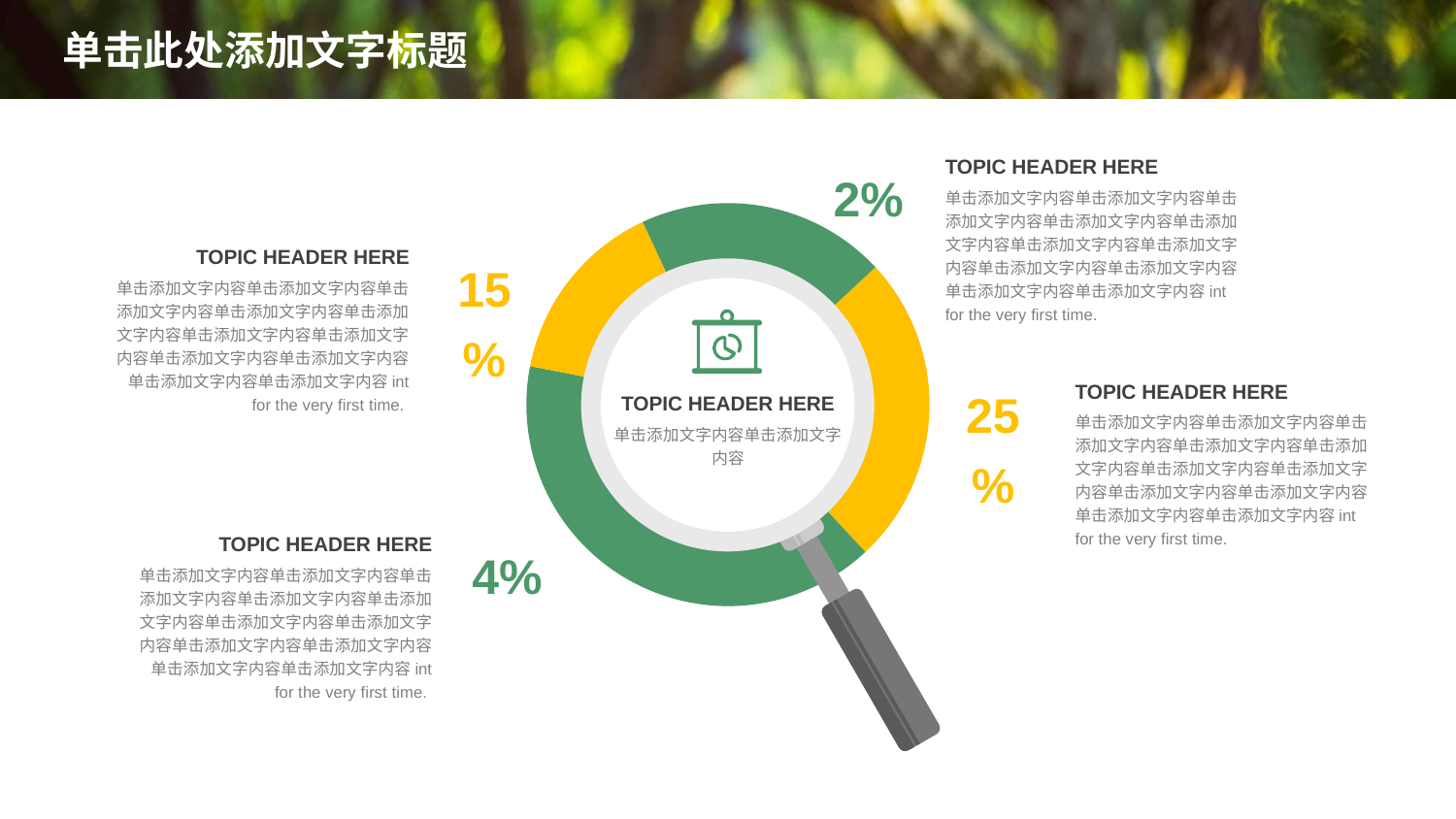
What kind of chart is shown on the slide? Donut (pie) chart How many segments does the donut chart have? 4 What percentage value is printed on the left side of the donut chart? 15% Which two colours are used for the segments of the donut chart? Green and yellow What is the smallest percentage value printed around the donut chart? 2% What text is shown as the header in the centre of the donut chart? TOPIC HEADER HERE What is the difference between the largest and smallest percentage values printed around the donut chart? 23 percentage points What percentage value is printed at the top right of the donut chart? 2% What percentage value is printed at the bottom left of the donut chart? 4% Which is larger, the value printed on the right side of the donut chart or the value printed on the left side? The right side (25%) What is the largest percentage value printed around the donut chart? 25%